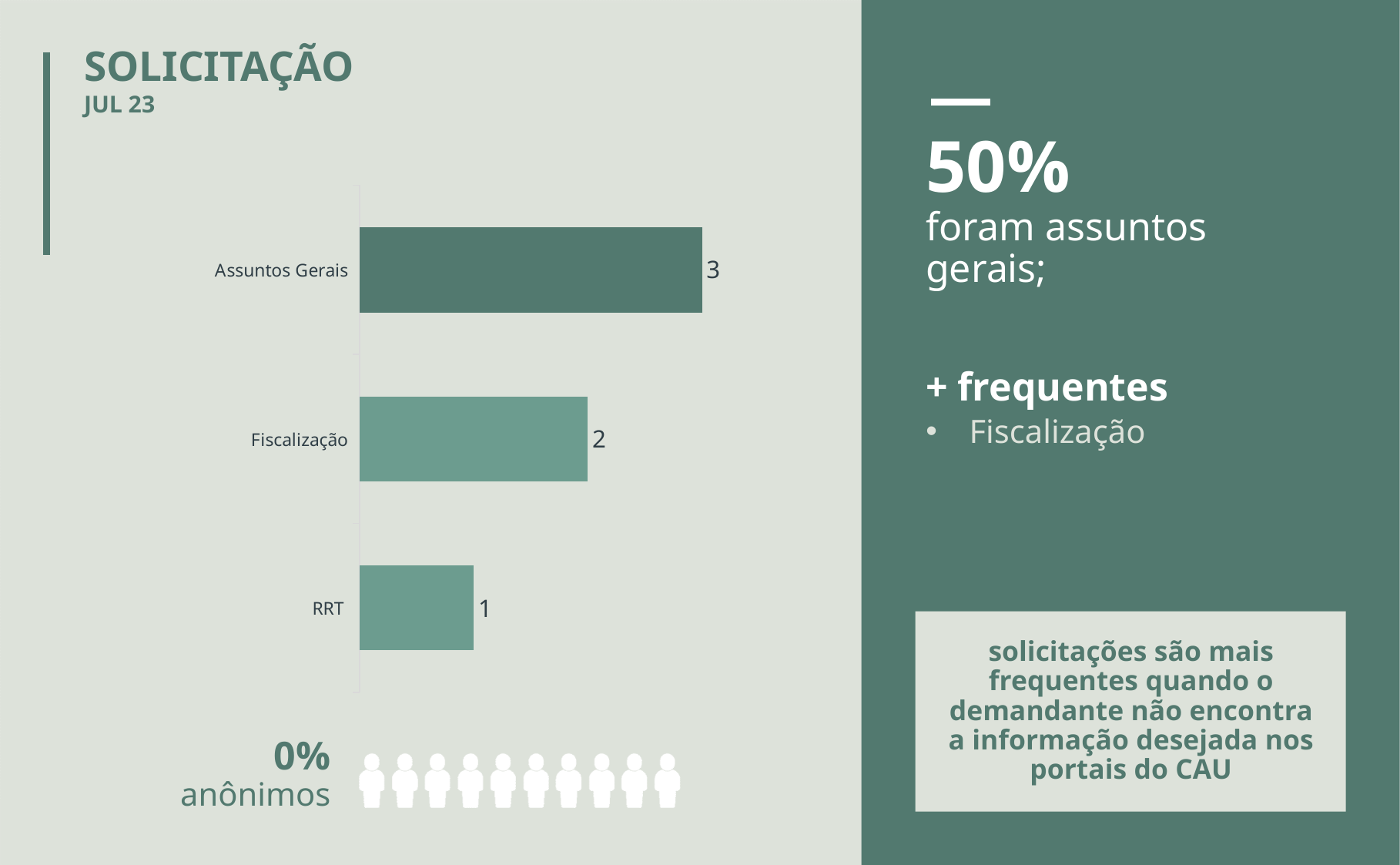
Which category has the highest value? Assuntos Gerais Which category has the lowest value? RRT What is the value for Fiscalização? 2 What is the difference between the values for Fiscalização and RRT? 1 What is the total of all the values shown in the chart? 6 What is the value for RRT? 1 What is the title of the chart? SOLICITAÇÃO What kind of chart is shown on the slide? bar chart Which is larger, the value for Fiscalização or the value for RRT? Fiscalização What is the value for Assuntos Gerais? 3 What is the difference between the values for Assuntos Gerais and RRT? 2 How many categories are shown in the chart? 3